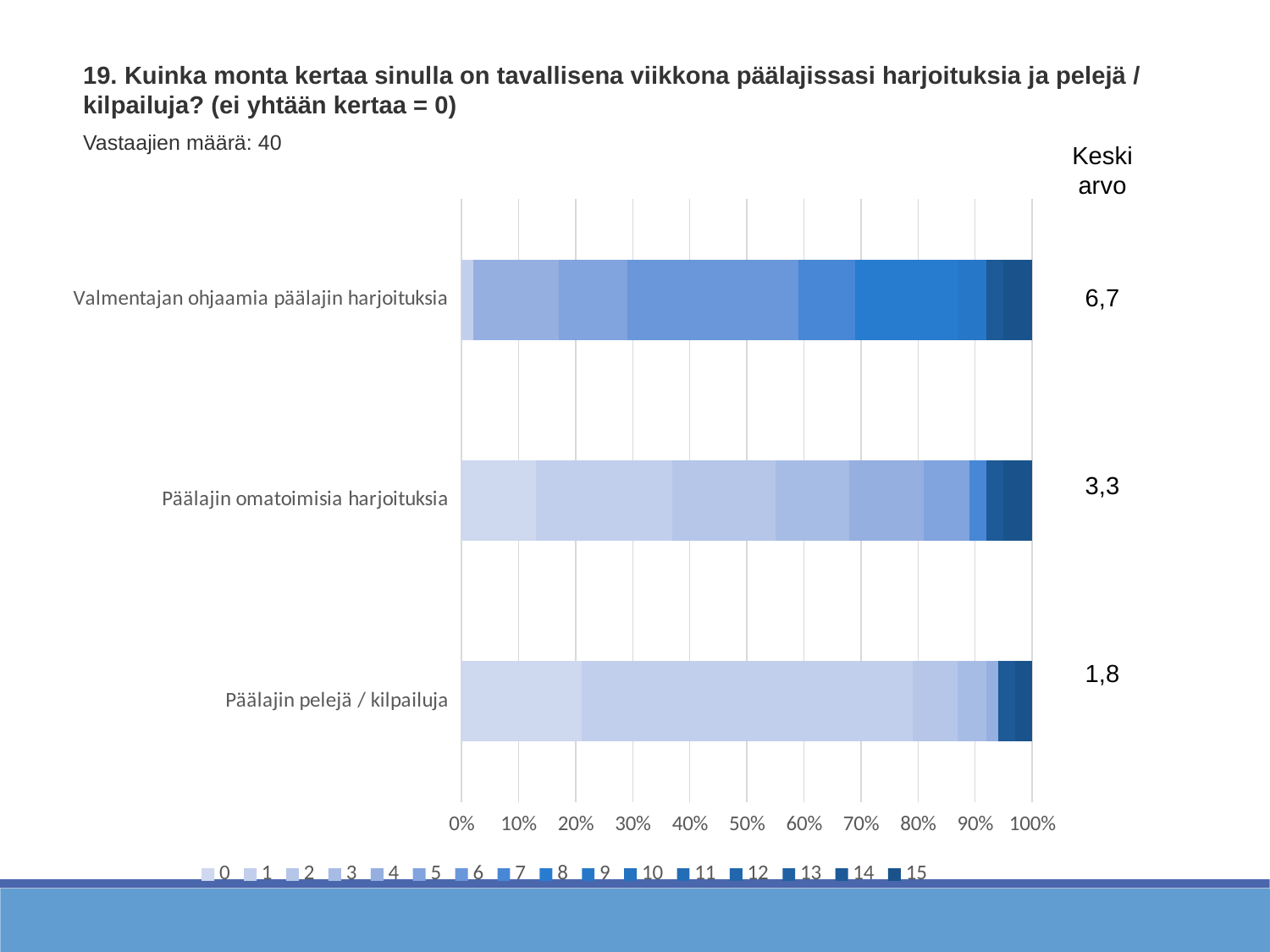
What is the Keskiarvo (mean) value shown for Päälajin omatoimisia harjoituksia? 3,3 What type of chart is shown on the slide? bar chart Which has a larger Keskiarvo value: Päälajin omatoimisia harjoituksia or Päälajin pelejä / kilpailuja? Päälajin omatoimisia harjoituksia What is the Keskiarvo (mean) value shown for Valmentajan ohjaamia päälajin harjoituksia? 6,7 How many series does the legend list? 16 What is the Keskiarvo (mean) value shown for Päälajin pelejä / kilpailuja? 1,8 Which category has the lowest Keskiarvo (mean) value? Päälajin pelejä / kilpailuja How many categories (bars) are plotted in the chart? 3 How many respondents (Vastaajien määrä) does the slide report? 40 What is the difference between the Keskiarvo values for Valmentajan ohjaamia päälajin harjoituksia and Päälajin pelejä / kilpailuja? 4,9 Which category has the highest Keskiarvo (mean) value? Valmentajan ohjaamia päälajin harjoituksia Is the share of the '0' segment in the Päälajin omatoimisia harjoituksia bar greater or less than 10%? greater